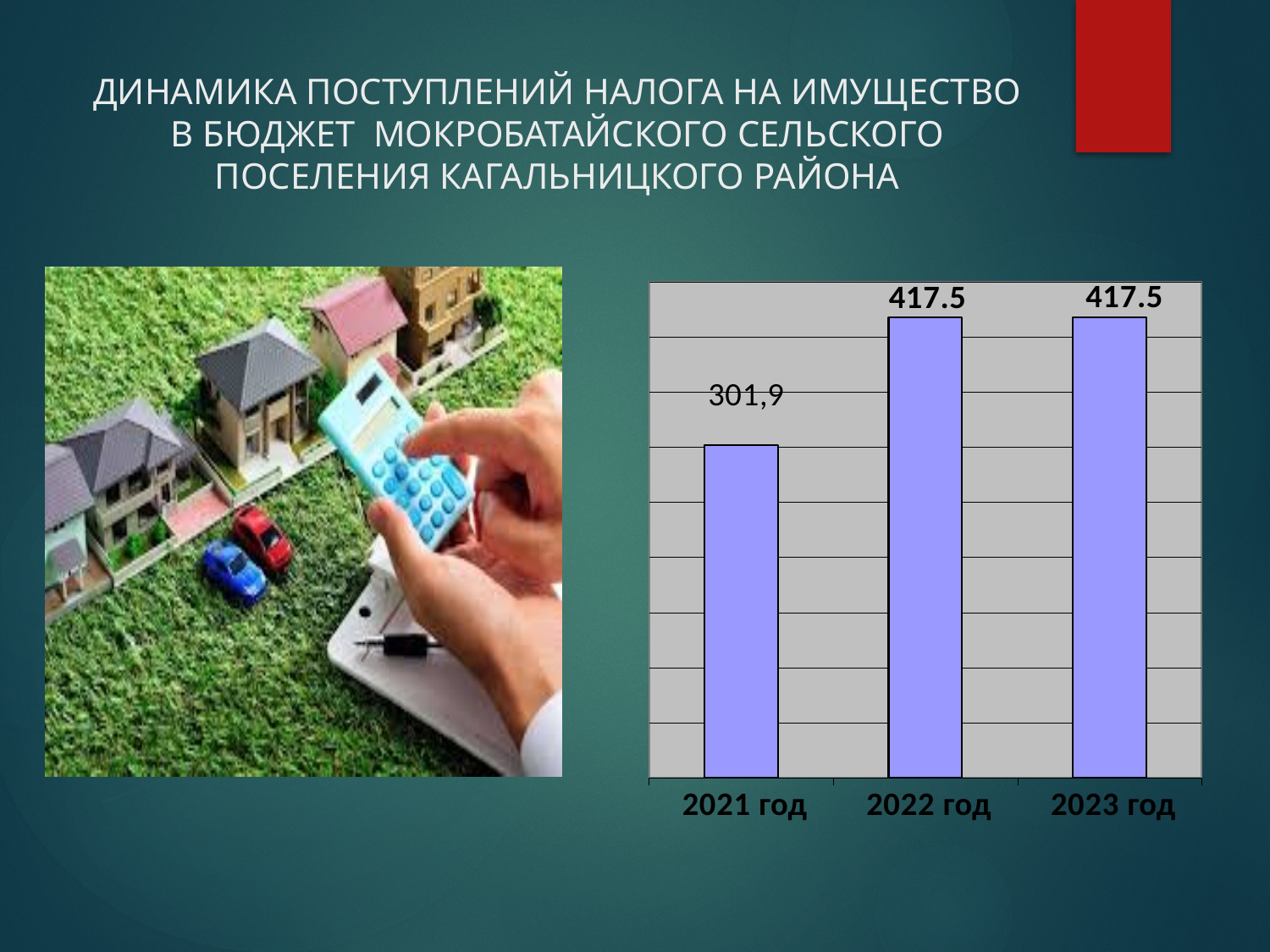
What is the value for 2023 год? 417.5 Which year has the lowest value? 2021 год What is the difference between the values for 2022 год and 2021 год? 115.6 What is the value for 2021 год? 301,9 Are the values for 2022 год and 2023 год equal? Yes How many years are shown on the chart? 3 What is the value for 2022 год? 417.5 Do the values rise or fall from 2021 год to 2022 год? Rise Which is larger, the value for 2021 год or the value for 2022 год? 2022 год What kind of chart is shown on the slide? Bar chart What is the first year shown on the x axis? 2021 год What colour are the bars in the chart? Light blue (lavender)